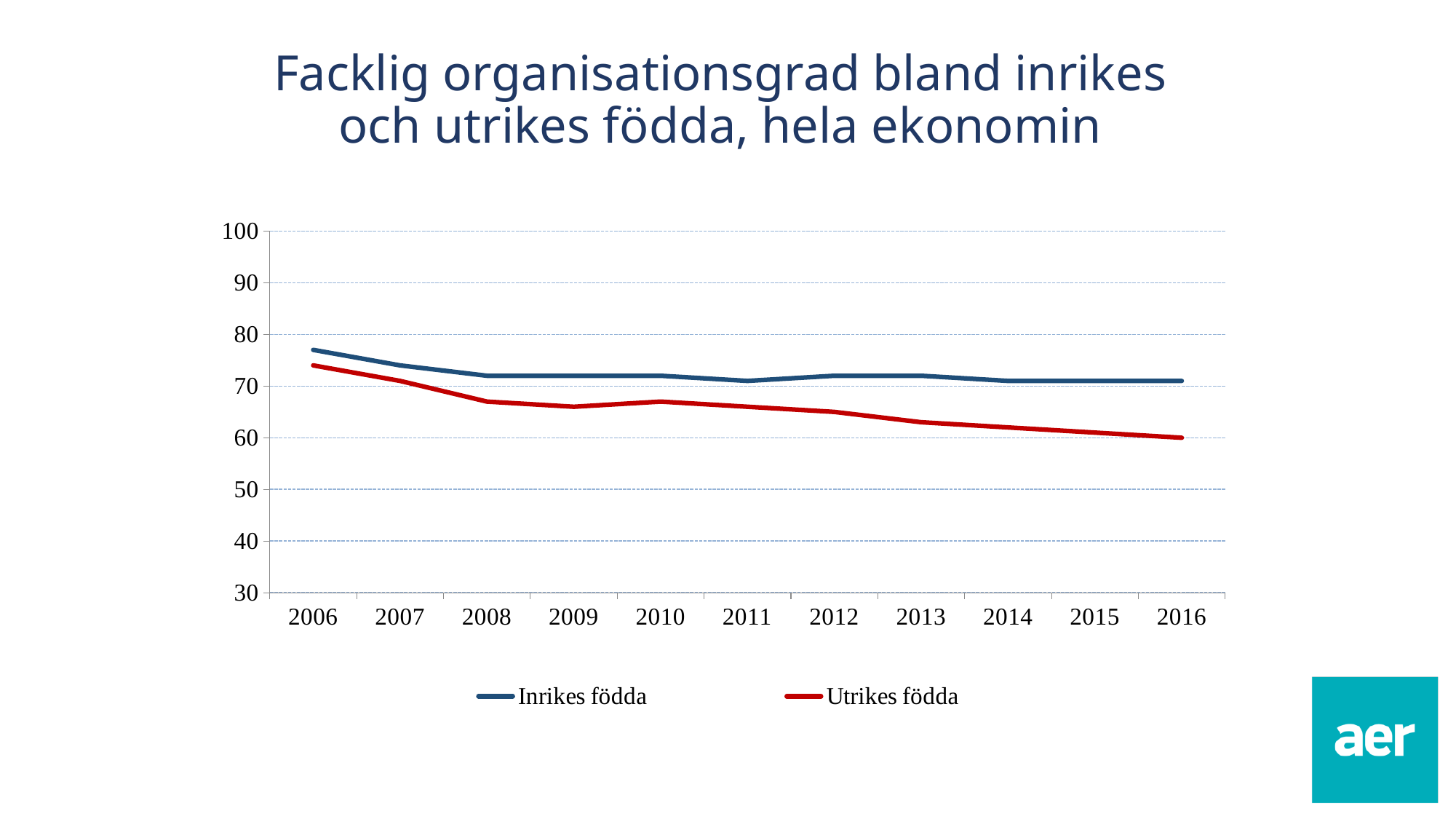
Does the value for Utrikes födda rise or fall from 2006 to 2016? fall Is the value for Inrikes födda in 2006 greater or less than 80? less How many series does the legend list? 2 Is the value for Utrikes födda in 2014 greater or less than 70? less What kind of chart is shown on the slide? line chart In which year is the value for Utrikes födda highest? 2006 How many years are plotted along the x axis? 11 Which series has the larger value in 2016, Inrikes födda or Utrikes födda? Inrikes födda In which year is the value for Utrikes födda lowest? 2016 Which series is shown in red in the legend? Utrikes födda In which year is the value for Inrikes födda highest? 2006 Is the value for Utrikes födda in 2006 greater or less than 70? greater